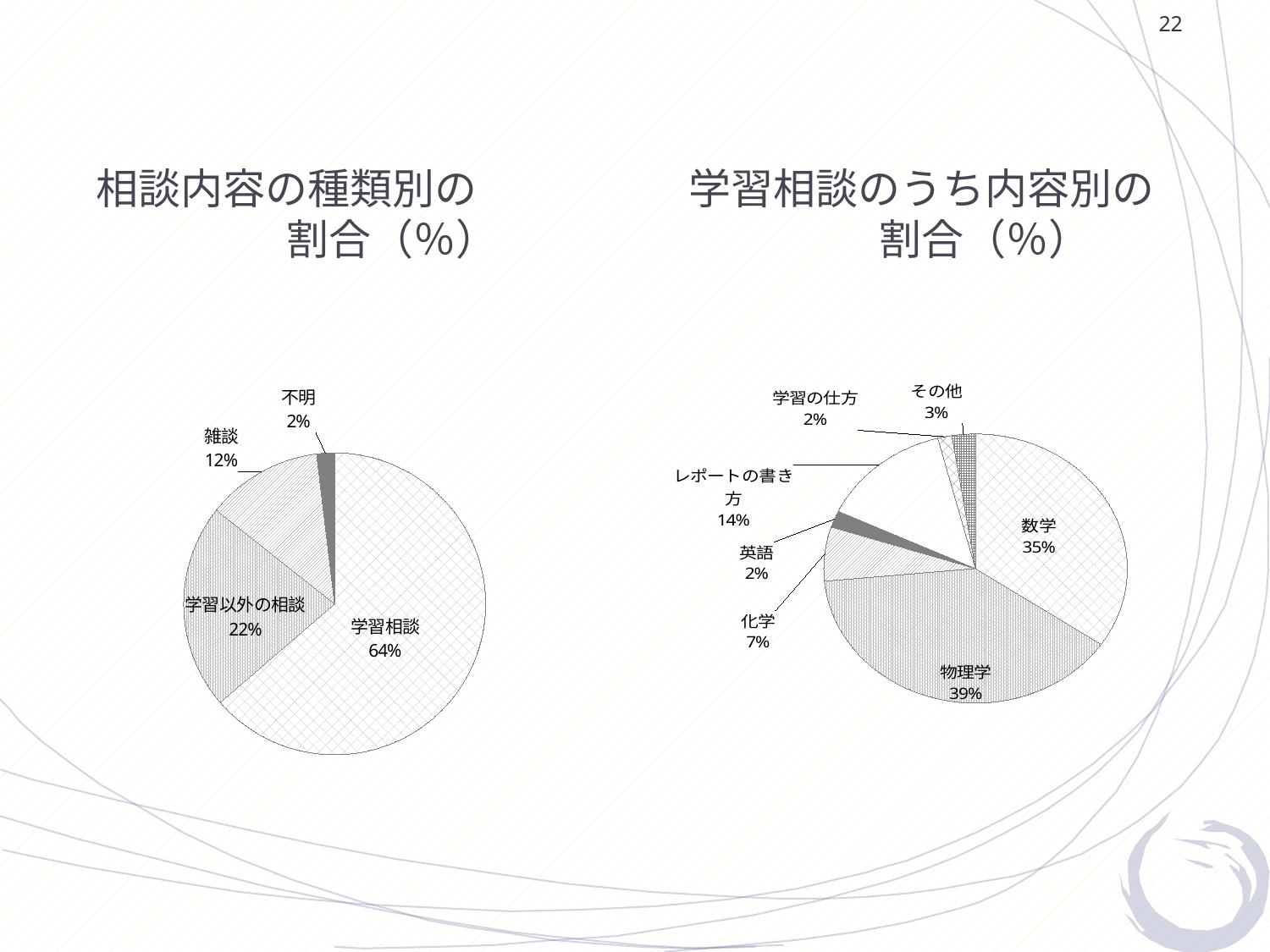
In the left chart (相談内容の種類別の割合), which category has the smallest share? 不明 What kind of chart is the left chart (相談内容の種類別の割合)? Pie chart In the right chart (学習相談のうち内容別の割合), which is larger, 化学 or その他? 化学 In the left chart (相談内容の種類別の割合), what percentage is 雑談? 12% In the right chart (学習相談のうち内容別の割合), what percentage is 物理学? 39% In the right chart (学習相談のうち内容別の割合), what is the difference between 物理学 and 数学? 4 percentage points In the left chart (相談内容の種類別の割合), what is the difference between 学習相談 and 学習以外の相談? 42 percentage points In the right chart (学習相談のうち内容別の割合), how many categories are shown? 7 In the right chart (学習相談のうち内容別の割合), which category has the largest share? 物理学 In the right chart (学習相談のうち内容別の割合), what percentage is レポートの書き方? 14% In the left chart (相談内容の種類別の割合), how many categories are shown? 4 In the left chart (相談内容の種類別の割合), what percentage is 学習相談? 64%